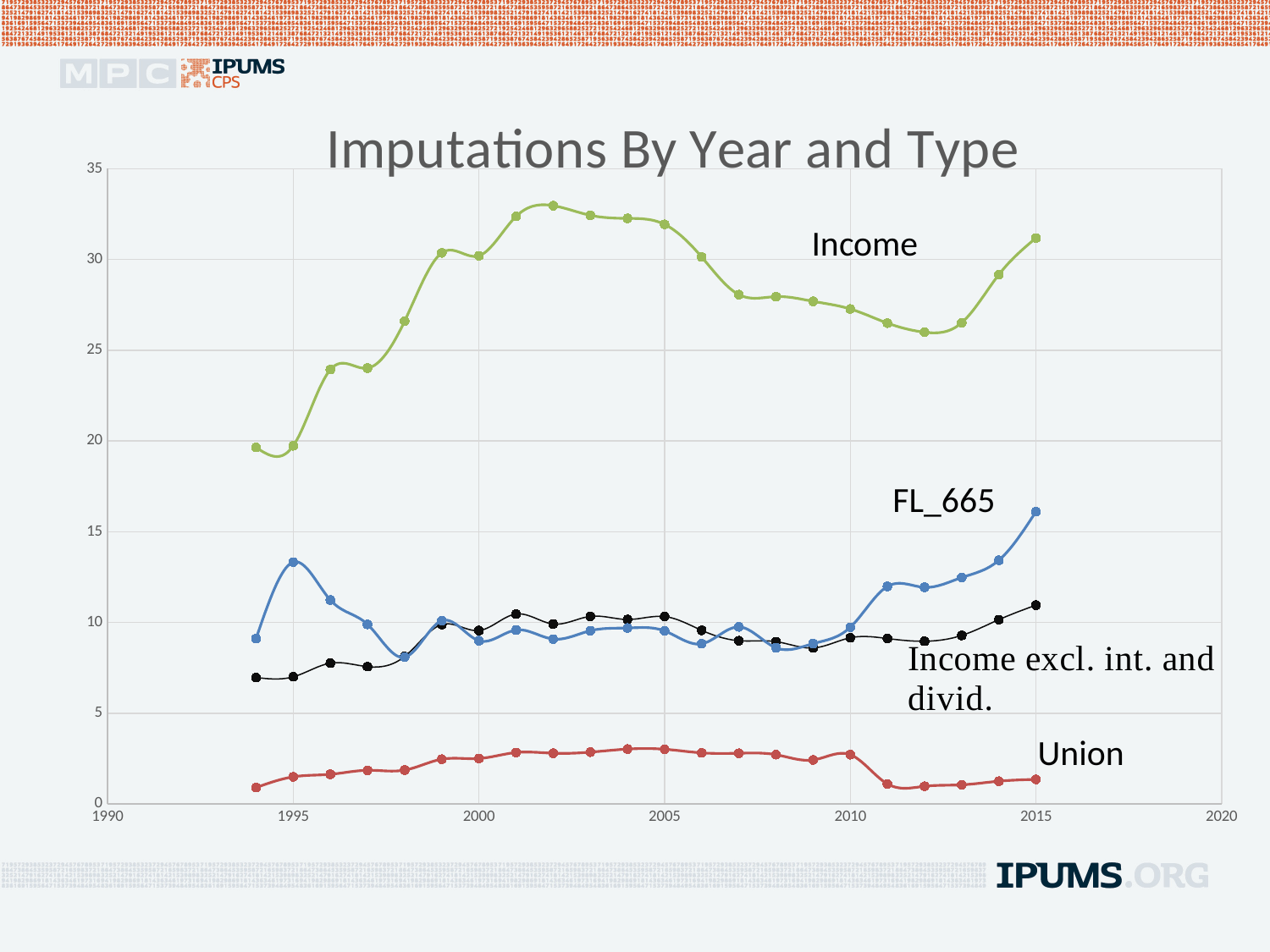
Which series has the lowest values across the chart? Union What is the title of the chart? Imputations By Year and Type Is the value for FL_665 in 2015 greater or less than 15? greater In which year does the Income series reach its highest value? 2002 Does the Income series rise or fall between 2012 and 2015? rise What kind of chart is shown on the slide? line chart Which is larger in 2015, FL_665 or Income excl. int. and divid.? FL_665 How many series are labelled on the chart? 4 Does the Union series rise or fall between 2010 and 2011? fall Is the value for Income in 2002 greater or less than 30? greater Which series has the highest values across the chart? Income Is the value for Union in 2005 greater or less than 5? less